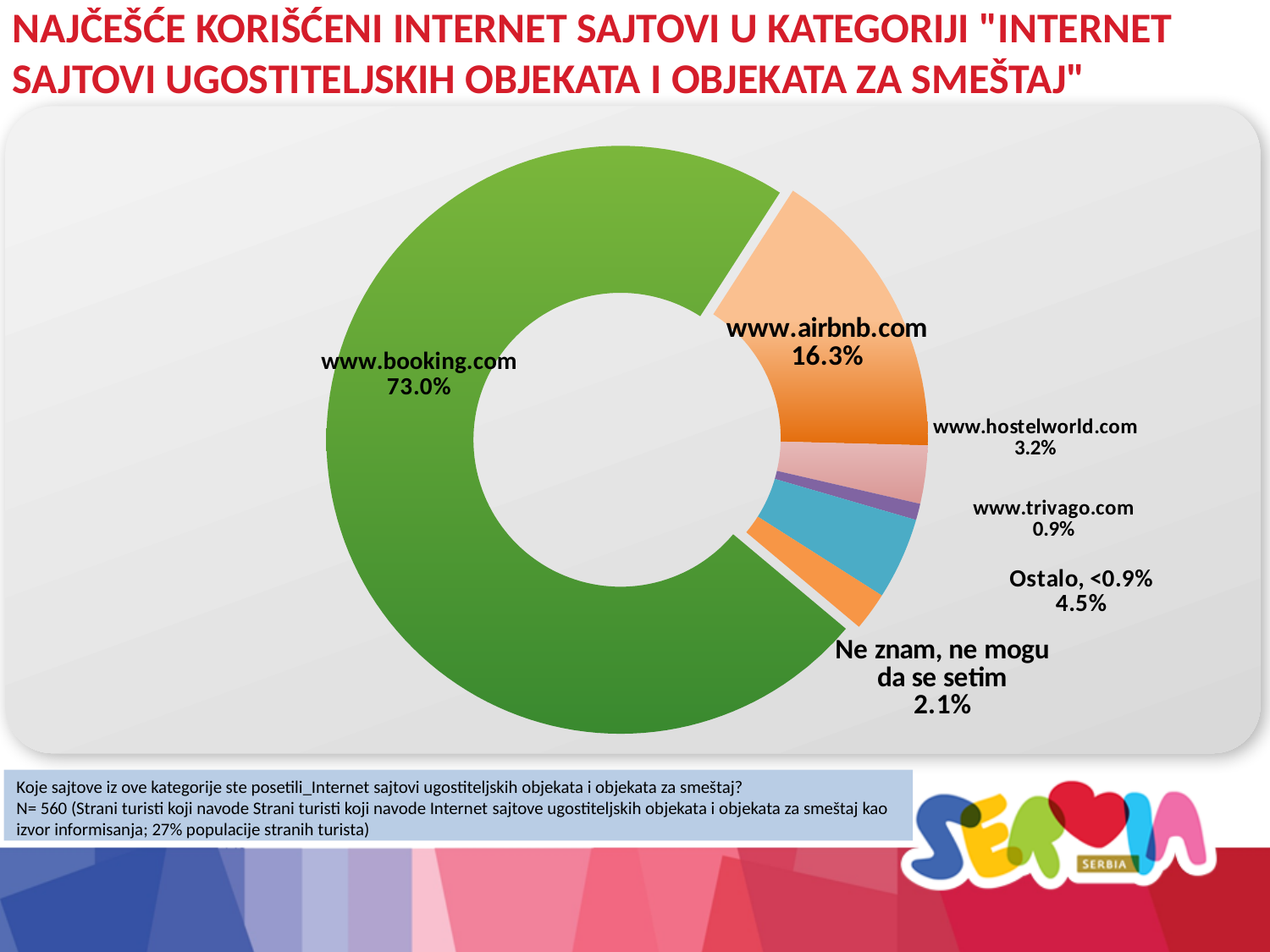
What colour is the www.booking.com slice? Green How many categories are shown in the chart? 6 What is the difference between the values for www.booking.com and www.airbnb.com? 56.7% Which is larger, the value for 'Ostalo, <0.9%' or the value for www.hostelworld.com? Ostalo, <0.9% What share of the chart does www.booking.com have? 73.0% Which category has the smallest slice of the chart? www.trivago.com What kind of chart is shown on the slide? Doughnut (pie) chart Which category has the largest slice of the chart? www.booking.com What is the value shown for www.hostelworld.com? 3.2% What is the value shown for www.airbnb.com? 16.3% What is the value shown for the 'Ne znam, ne mogu da se setim' slice? 2.1% What is the value shown for www.trivago.com? 0.9%